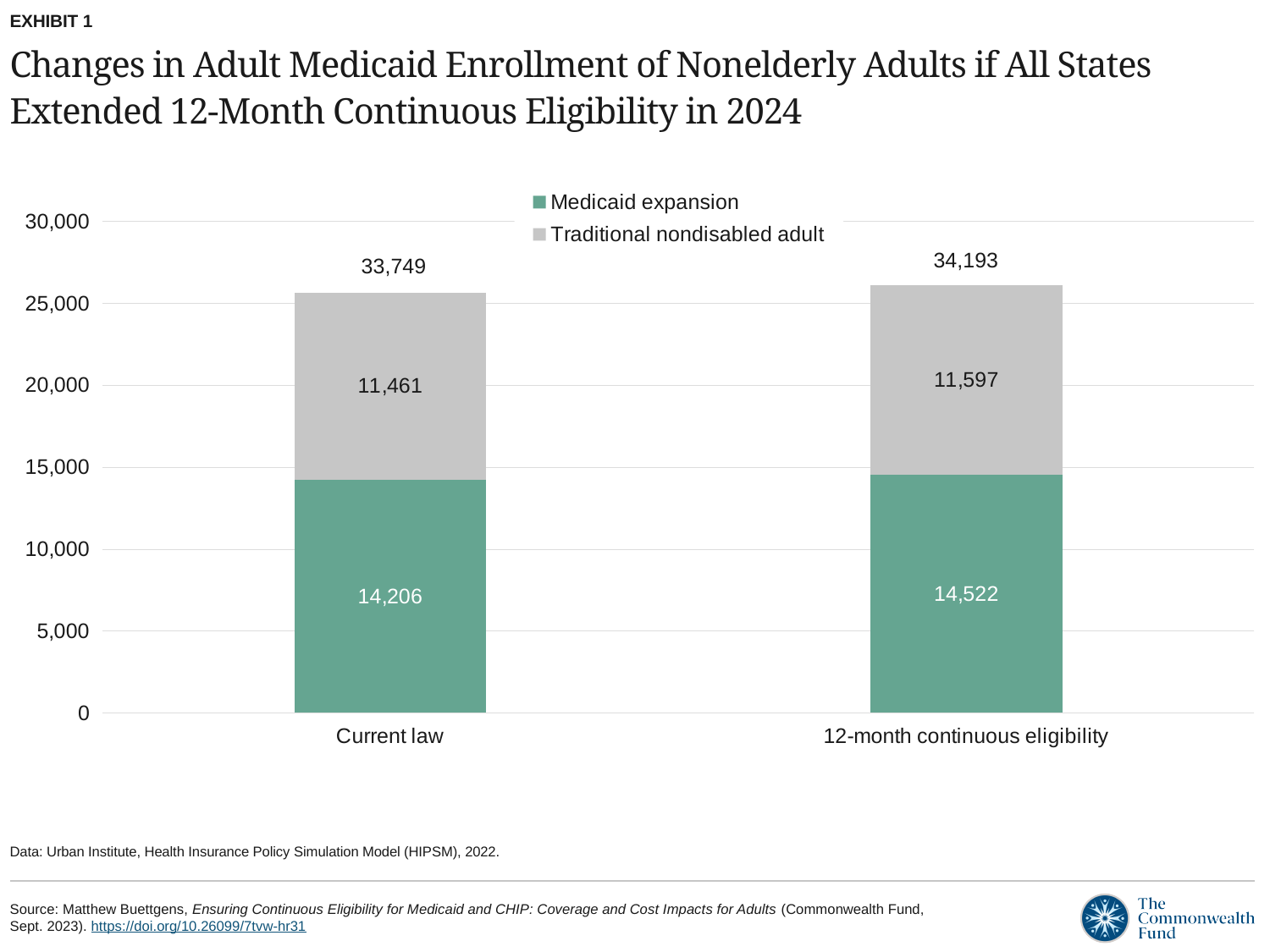
Which colour represents the Medicaid expansion series? Green What is the difference between the Medicaid expansion values for 12-month continuous eligibility and Current law? 316 What is the Medicaid expansion value for Current law? 14,206 What is the difference between the Traditional nondisabled adult values for 12-month continuous eligibility and Current law? 136 What is the Traditional nondisabled adult value for Current law? 11,461 How many categories are shown on the x axis? 2 What is the Traditional nondisabled adult value for 12-month continuous eligibility? 11,597 What is the Medicaid expansion value for 12-month continuous eligibility? 14,522 What is the label printed above the 12-month continuous eligibility bar? 34,193 How many series does the legend list? 2 What kind of chart is shown on the slide? Stacked bar chart Which series is larger for Current law, Medicaid expansion or Traditional nondisabled adult? Medicaid expansion